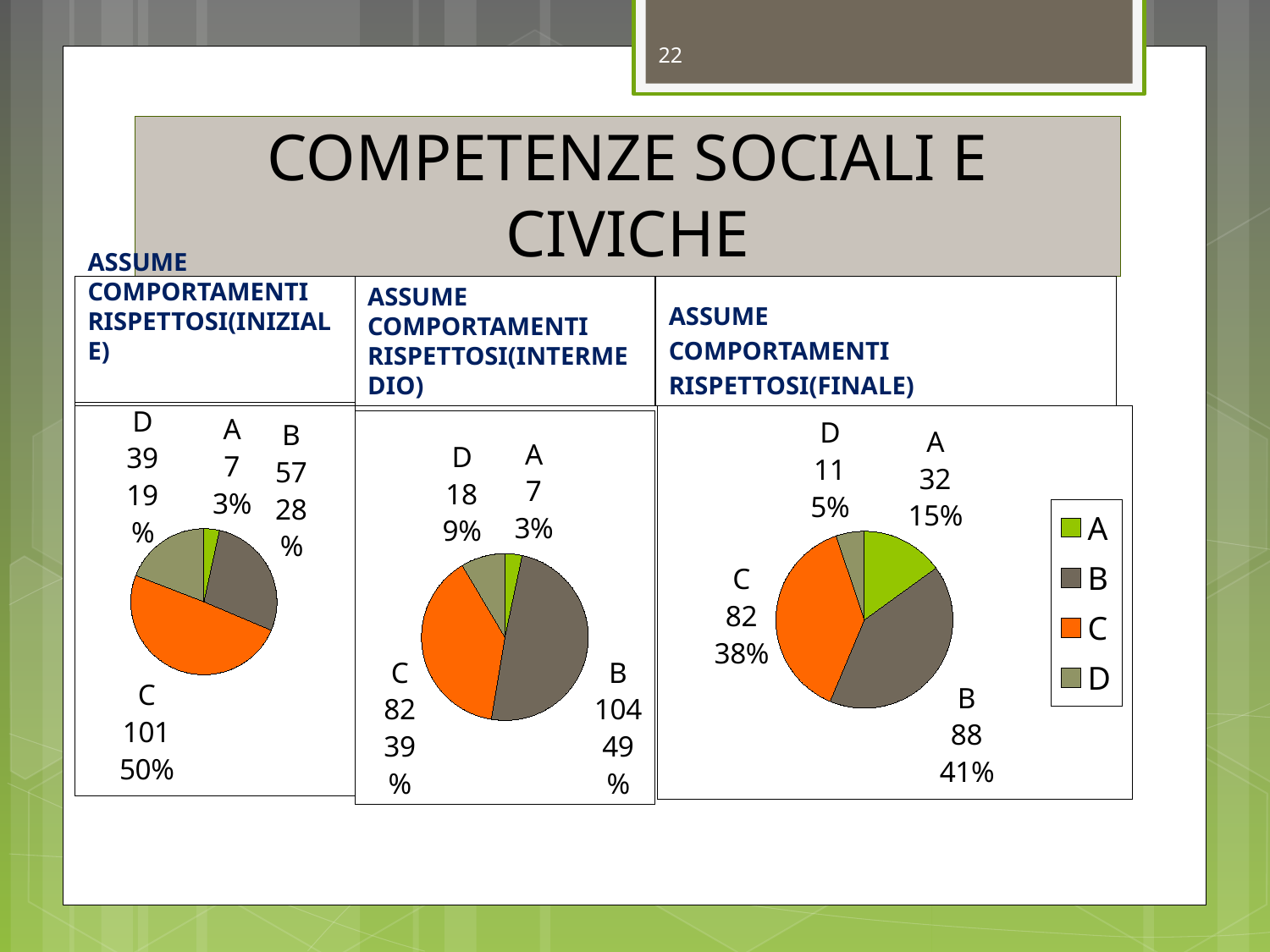
In the ASSUME COMPORTAMENTI RISPETTOSI(FINALE) chart, what is the value for category A? 32 In the ASSUME COMPORTAMENTI RISPETTOSI(INTERMEDIO) chart, what percentage share does category D have? 9% What kind of chart is used for ASSUME COMPORTAMENTI RISPETTOSI(FINALE)? Pie chart In the ASSUME COMPORTAMENTI RISPETTOSI(INTERMEDIO) chart, which category has the largest slice? B In the ASSUME COMPORTAMENTI RISPETTOSI(INTERMEDIO) chart, what is the difference between the values for B and C? 22 In the ASSUME COMPORTAMENTI RISPETTOSI(INIZIALE) chart, what is the value for category C? 101 In the ASSUME COMPORTAMENTI RISPETTOSI(INIZIALE) chart, which category has the smallest slice? A In the ASSUME COMPORTAMENTI RISPETTOSI(INIZIALE) chart, what percentage share does category B have? 28% How many entries does the legend on the right of the slide list? 4 In the ASSUME COMPORTAMENTI RISPETTOSI(FINALE) chart, which is larger, the value for B or the value for C? B In the ASSUME COMPORTAMENTI RISPETTOSI(INTERMEDIO) chart, what is the value for category B? 104 In the ASSUME COMPORTAMENTI RISPETTOSI(FINALE) chart, what percentage share does category D have? 5%